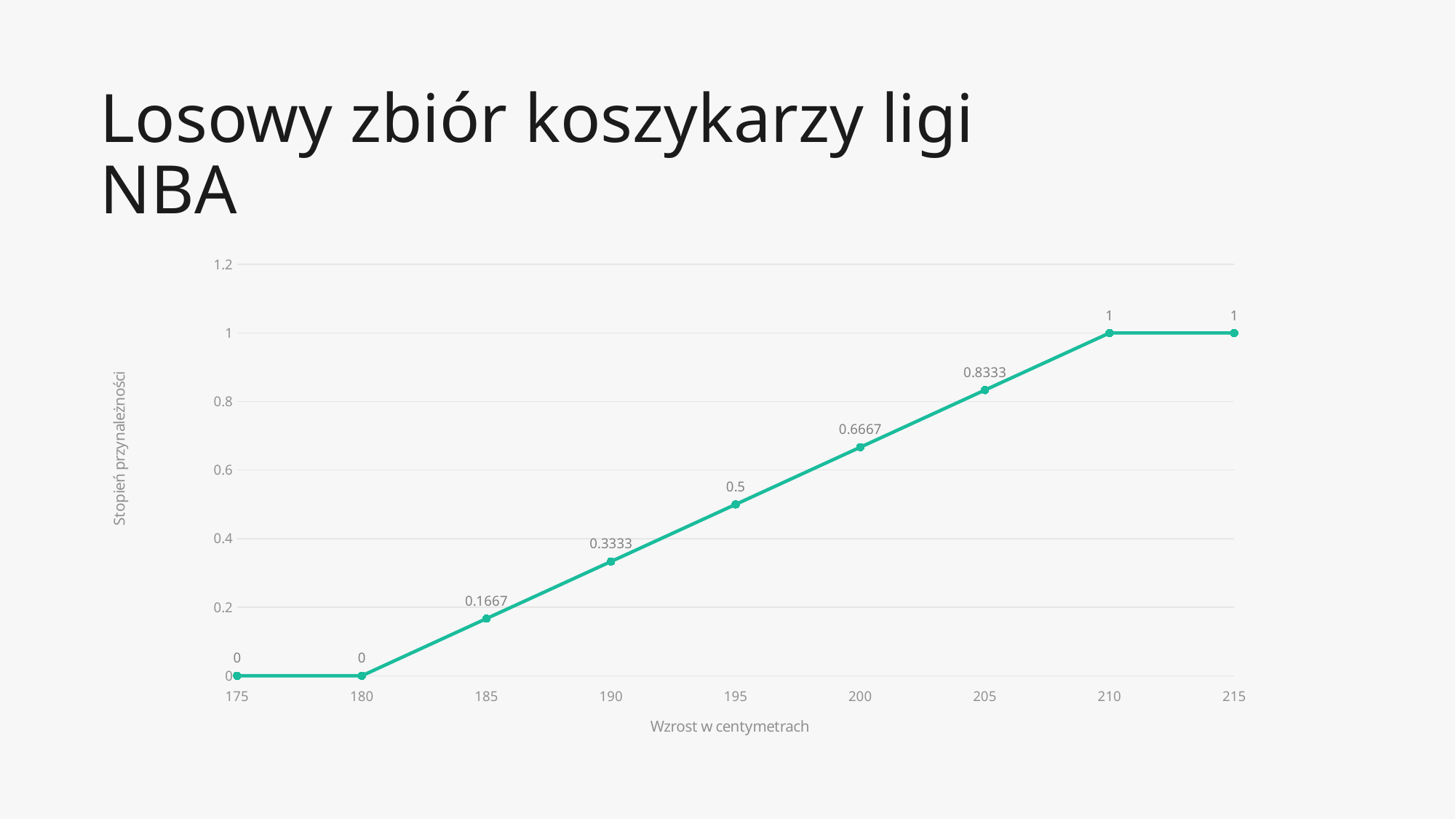
What is the value plotted at 185 cm? 0.1667 What is the label of the x axis? Wzrost w centymetrach What kind of chart is shown on the slide? line chart Is the value at 205 cm greater or less than 0.8? greater What is the membership degree (Stopień przynależności) at a height of 195 cm? 0.5 What is the label of the y axis? Stopień przynależności What is the difference between the values at 200 cm and 190 cm? 0.3334 Do the values rise or fall as height increases from 180 cm to 210 cm? rise How many data points are plotted on the line? 9 What is the value plotted at 205 cm? 0.8333 Which is larger, the value at 190 cm or the value at 200 cm? 200 cm What is the value plotted at 180 cm? 0